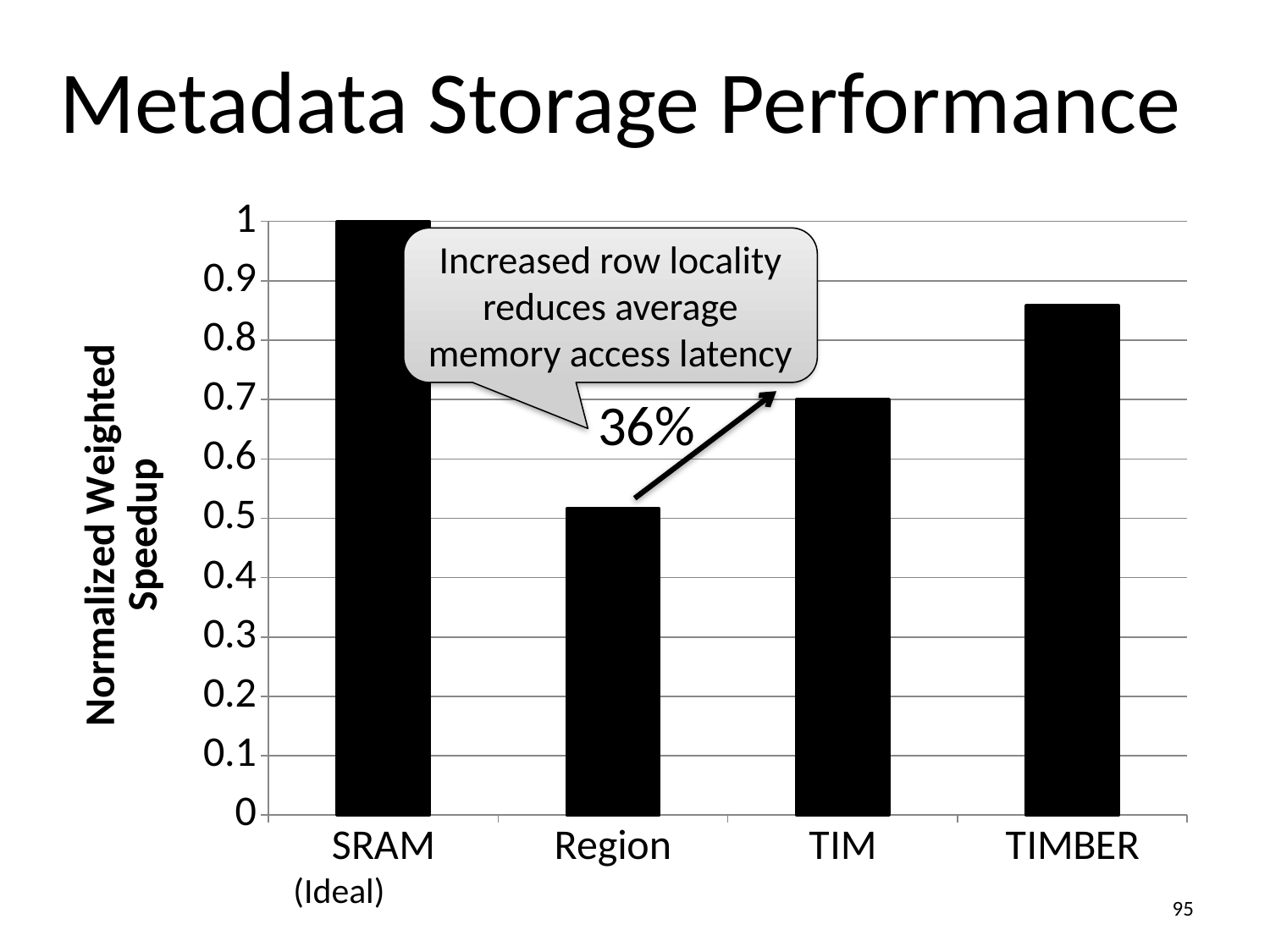
Is the value for TIM greater or less than 0.6? greater Is the value for Region greater or less than 0.6? less Which category has the highest normalized weighted speedup? SRAM (Ideal) What percentage is annotated next to the arrow between the Region and TIM bars? 36% What is the normalized weighted speedup for SRAM (Ideal)? 1 What is the label of the y axis? Normalized Weighted Speedup Which has a higher normalized weighted speedup, TIMBER or TIM? TIMBER Is the value for TIMBER greater or less than 0.8? greater Which has a higher normalized weighted speedup, Region or TIM? TIM Which category has the lowest normalized weighted speedup? Region What kind of chart is shown on the slide? bar chart How many categories are plotted on the x axis? 4